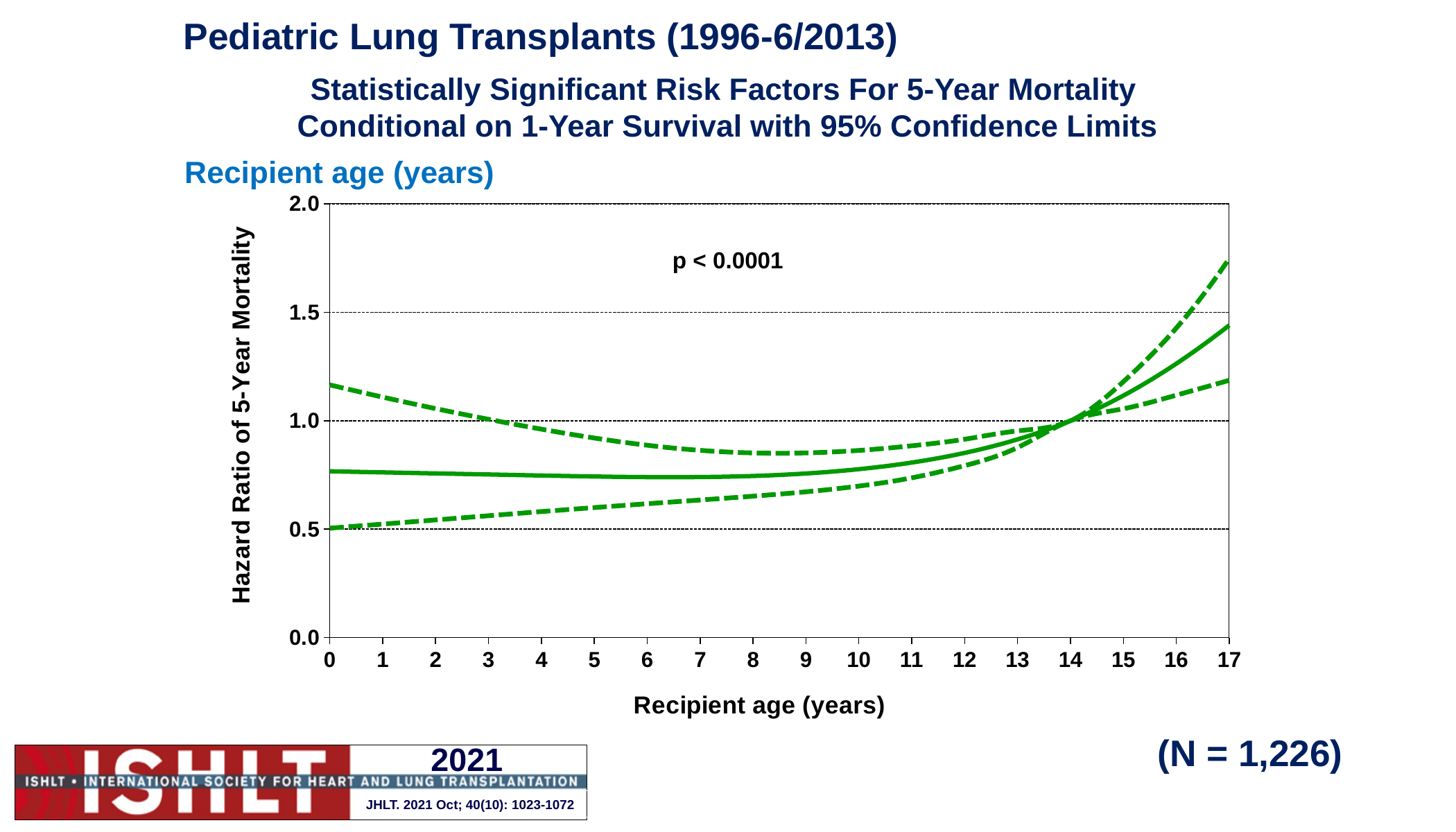
What is the highest recipient age shown on the x axis? 17 Is the hazard ratio on the solid line at recipient age 0 greater or less than 1.0? less Is the lower dashed confidence limit at recipient age 17 greater or less than 1.0? greater Which is larger: the solid-line hazard ratio at recipient age 17 or at recipient age 0? Age 17 Is the hazard ratio on the solid line at recipient age 0 greater or less than 0.5? greater Does the solid hazard ratio line rise or fall between recipient age 10 and recipient age 17? rises What kind of chart is shown on the slide? Line chart What p-value is printed on the chart? p < 0.0001 What is the label of the y axis? Hazard Ratio of 5-Year Mortality